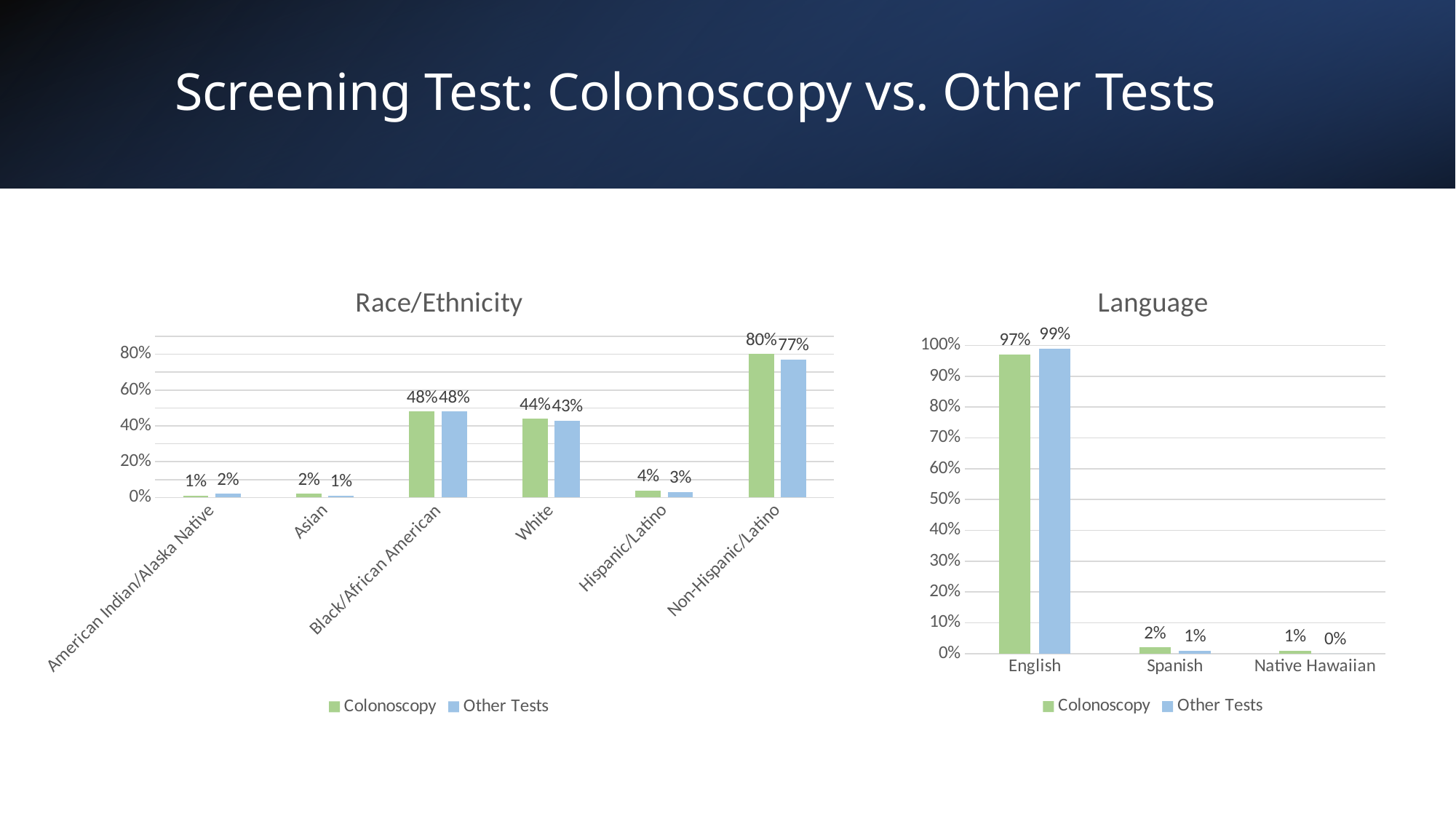
In the Race/Ethnicity chart, which category has the highest Colonoscopy value? Non-Hispanic/Latino In the Race/Ethnicity chart, what is the Colonoscopy value for Non-Hispanic/Latino? 80% In the Race/Ethnicity chart, what is the difference between the Colonoscopy and Other Tests values for Non-Hispanic/Latino? 3% In the Race/Ethnicity chart, what is the Other Tests value for White? 43% What type of chart is the Race/Ethnicity chart? Bar chart In the Race/Ethnicity chart, how many race/ethnicity categories are shown? 6 In the Language chart, what is the Colonoscopy value for Spanish? 2% How many series does the legend of the Language chart list? 2 In the Language chart, which is larger for English: the Colonoscopy value or the Other Tests value? Other Tests In the Language chart, what is the Other Tests value for English? 99% In the Race/Ethnicity chart, is the Colonoscopy value for Black/African American greater or less than 40%? greater In the Language chart, which language has the lowest Other Tests value? Native Hawaiian